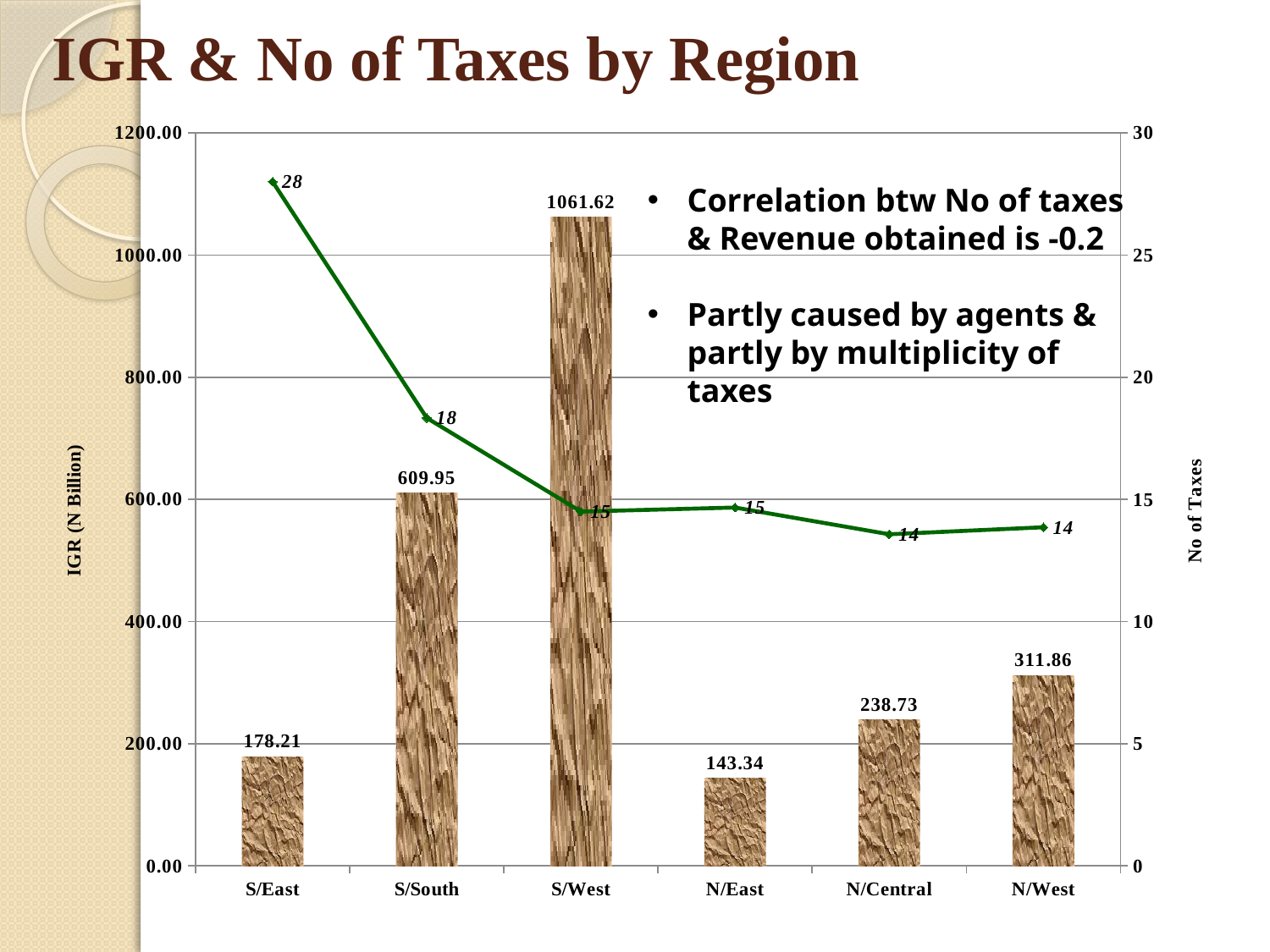
What is the IGR (N Billion) value for N/Central? 238.73 Which region has a larger IGR (N Billion), N/West or N/Central? N/West How many regions are shown on the x axis? 6 What is the No of Taxes value for S/South? 18 What is the title of the chart? IGR & No of Taxes by Region What is the No of Taxes value for S/East? 28 Does the No of Taxes line generally rise or fall from S/East to N/West? fall Which region has the lowest IGR (N Billion)? N/East Which region has the highest IGR (N Billion)? S/West Which region has the highest No of Taxes? S/East What is the IGR (N Billion) value for S/West? 1061.62 What is the difference in IGR (N Billion) between S/South and S/East? 431.74